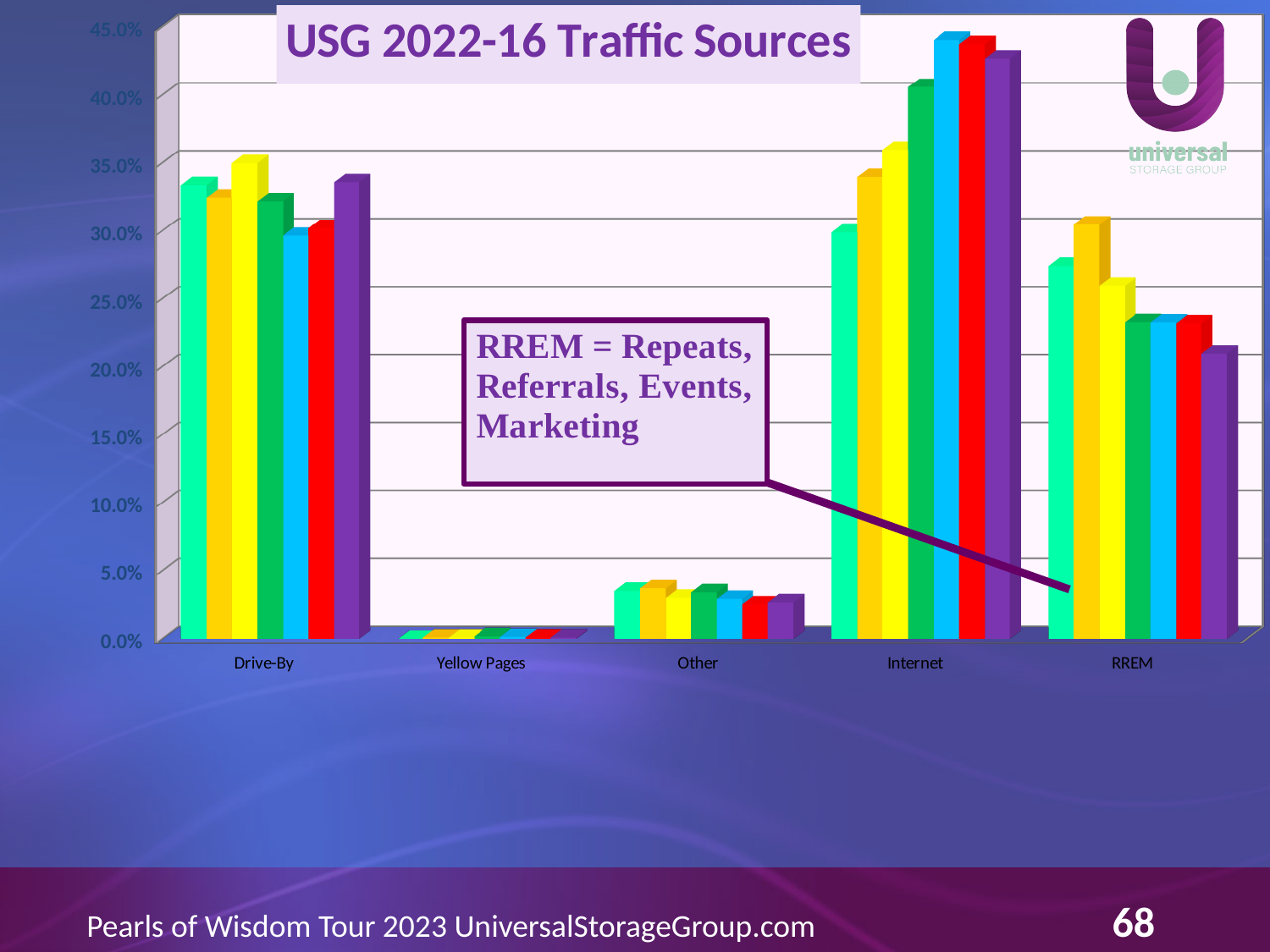
Which category has larger values, Other or Internet? Internet Which category has larger values, Drive-By or RREM? Drive-By What kind of chart is shown on the slide? bar chart Are the values for Yellow Pages greater or less than 5.0%? less How many bars are plotted for the Drive-By category? 7 Are the values for Other greater or less than 10.0%? less How many categories are shown on the x axis of the chart? 5 Which category has the lowest values in the chart? Yellow Pages Which category has the highest values in the chart? Internet Are the values for Internet greater or less than 25.0%? greater According to the callout on the slide, what does RREM stand for? Repeats, Referrals, Events, Marketing What is the title of the chart? USG 2022-16 Traffic Sources